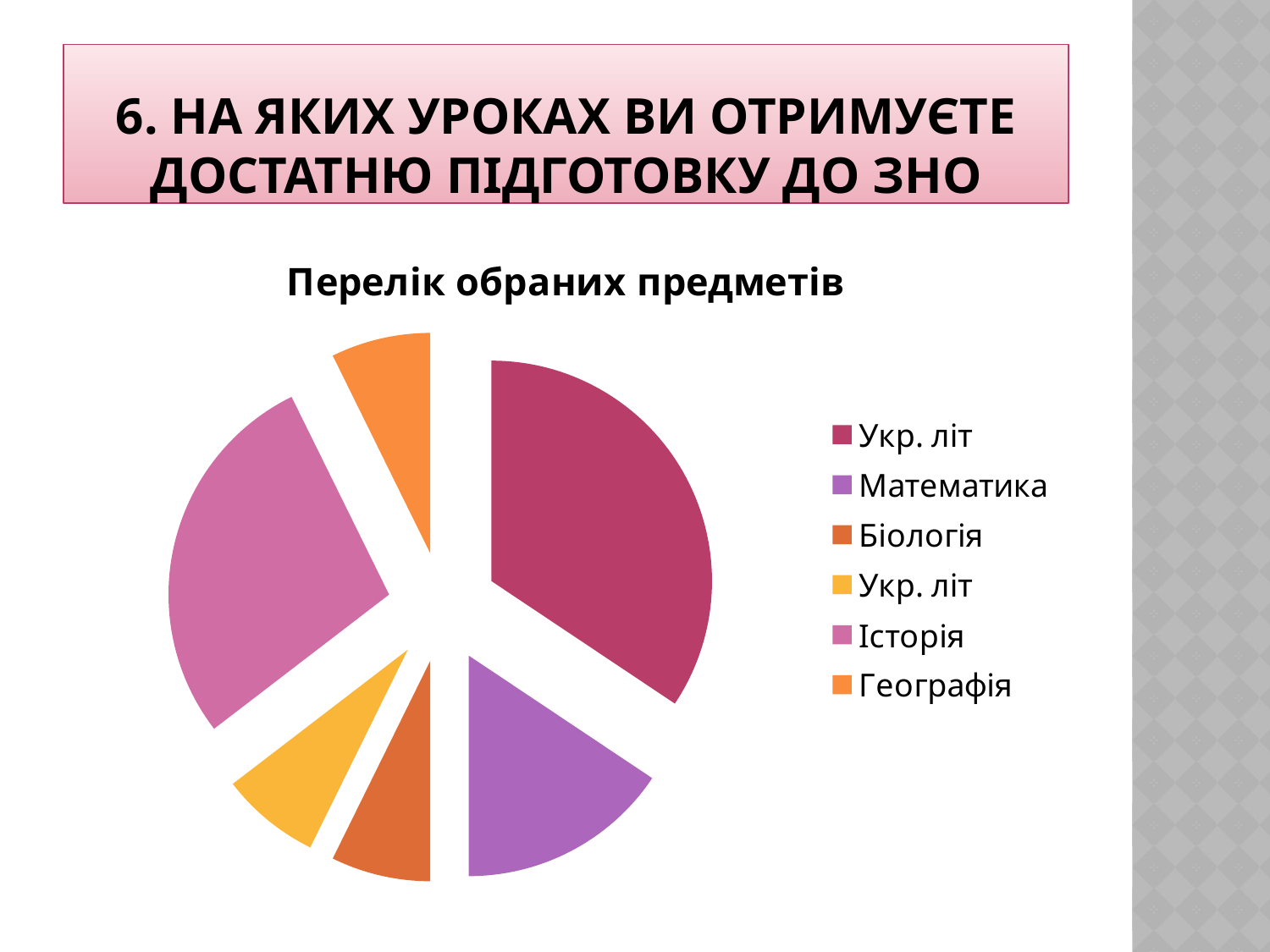
How many entries does the legend list? 6 Which slice is larger, Історія or Географія? Історія Which slice is larger, the dark red Укр. літ slice or the Математика slice? Укр. літ (dark red) What kind of chart is shown on the slide? pie chart What colour is the Історія slice? pink Which legend label appears twice in the legend? Укр. літ Which slice is larger, Математика or Біологія? Математика What is the title of the chart? Перелік обраних предметів How many slices does the pie chart have? 6 Which category has the largest slice of the pie? Укр. літ (dark red slice)